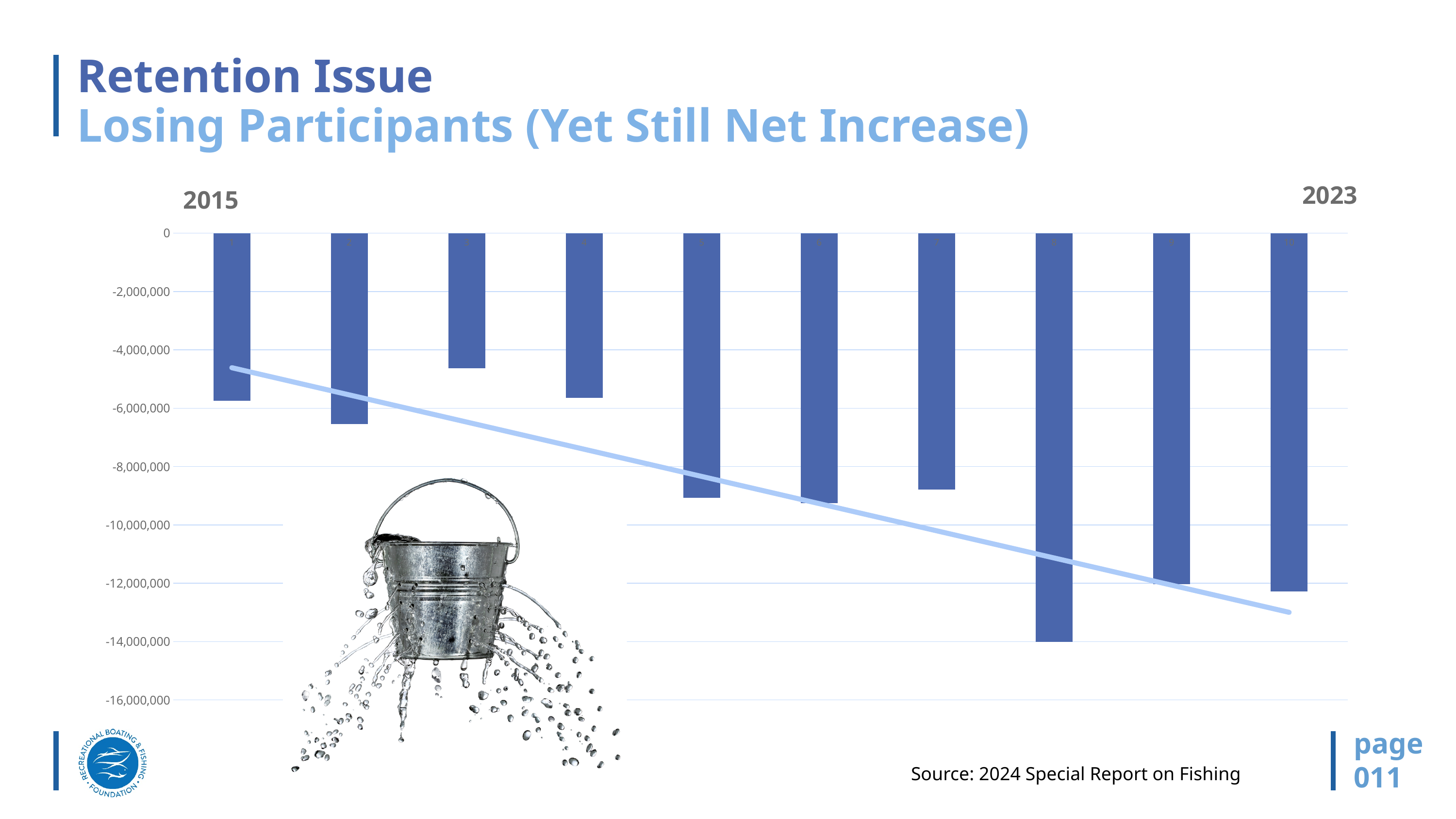
Which bar shows a larger loss, the first bar or the second bar? the second bar Which bar extends furthest below zero (the largest loss)? the eighth bar How many bars are plotted in the chart? 10 Is the value for the third bar greater or less than -6,000,000? greater Overall, do the values rise or fall (become more negative) from left to right across the chart? fall Is the value for the last bar (2023) greater or less than -10,000,000? less Is the value for the eighth bar greater or less than -12,000,000? less Which bar shows the smallest loss (closest to zero)? the third bar What is the subtitle of the slide below 'Retention Issue'? Losing Participants (Yet Still Net Increase) What kind of chart is shown on the slide? bar chart Which two years are labeled at the left and right ends of the chart? 2015 and 2023